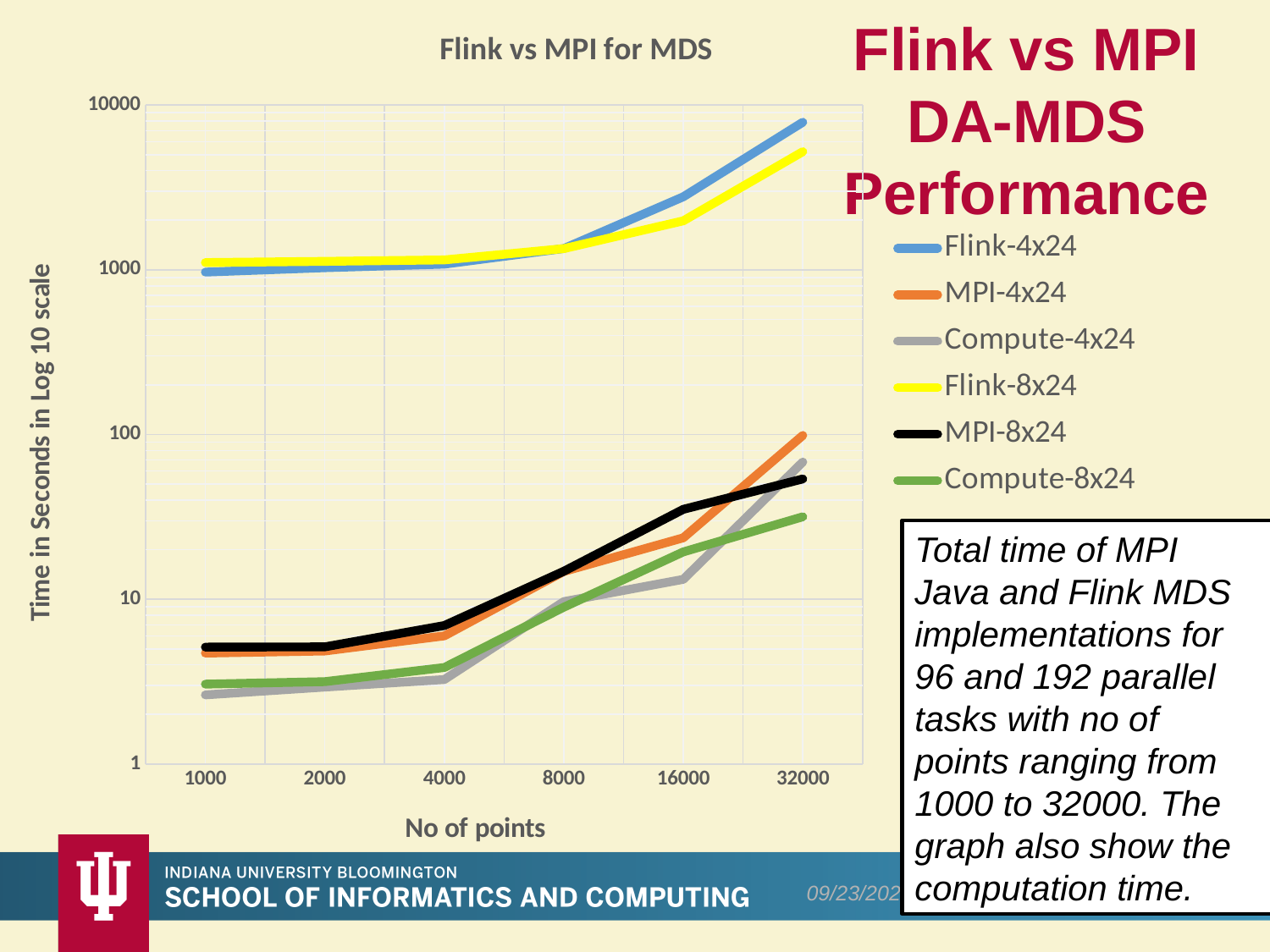
What kind of chart is shown on the slide? line chart What is the title of the chart? Flink vs MPI for MDS Does the time for Flink-4x24 rise or fall as the number of points increases? rise Which series has the highest value at 32000 points? Flink-4x24 Is the value for Flink-4x24 at 32000 points greater or less than 1000? greater Is the value for MPI-8x24 at 1000 points greater or less than 10? less How many series does the legend list? 6 Which series has the lowest value at 32000 points? Compute-8x24 How many points are plotted along the x axis for each series? 6 At 1000 points, which is larger: MPI-8x24 or Compute-8x24? MPI-8x24 Is the value for Compute-8x24 at 32000 points greater or less than 100? less At 32000 points, which is larger: Flink-4x24 or Flink-8x24? Flink-4x24